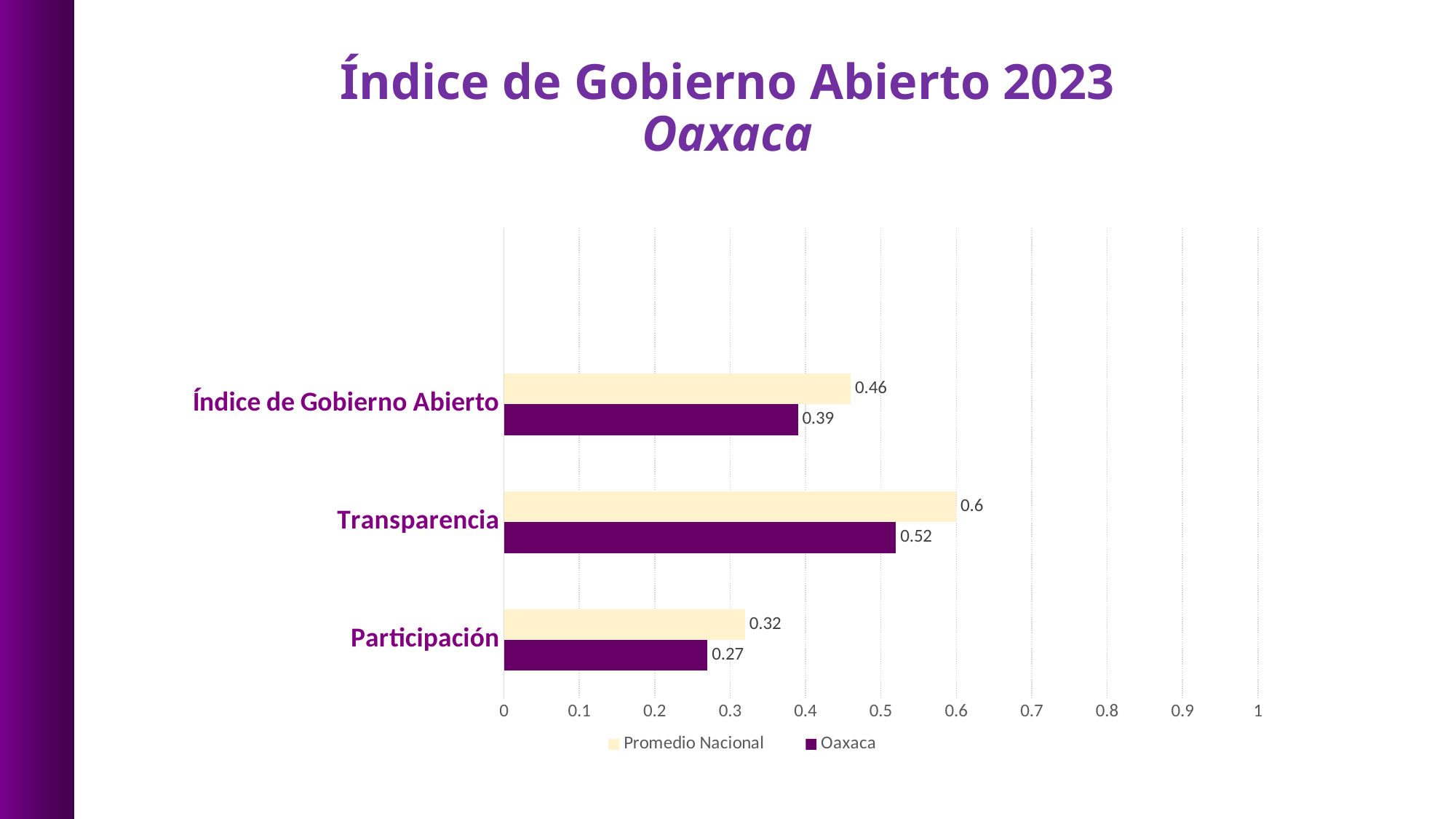
How many categories are shown on the chart? 3 What is the difference between the Promedio Nacional and Oaxaca values for Índice de Gobierno Abierto? 0.07 What kind of chart is shown on the slide? Bar chart Which category has the highest Oaxaca value? Transparencia What is the Promedio Nacional value for Participación? 0.32 Which category has the lowest Promedio Nacional value? Participación What is the Promedio Nacional value for Transparencia? 0.6 What is the Oaxaca value for Transparencia? 0.52 What is the difference between the Promedio Nacional and Oaxaca values for Transparencia? 0.08 What is the Oaxaca value for Índice de Gobierno Abierto? 0.39 How many series does the legend list? 2 Which is larger for Participación, the Promedio Nacional value or the Oaxaca value? Promedio Nacional